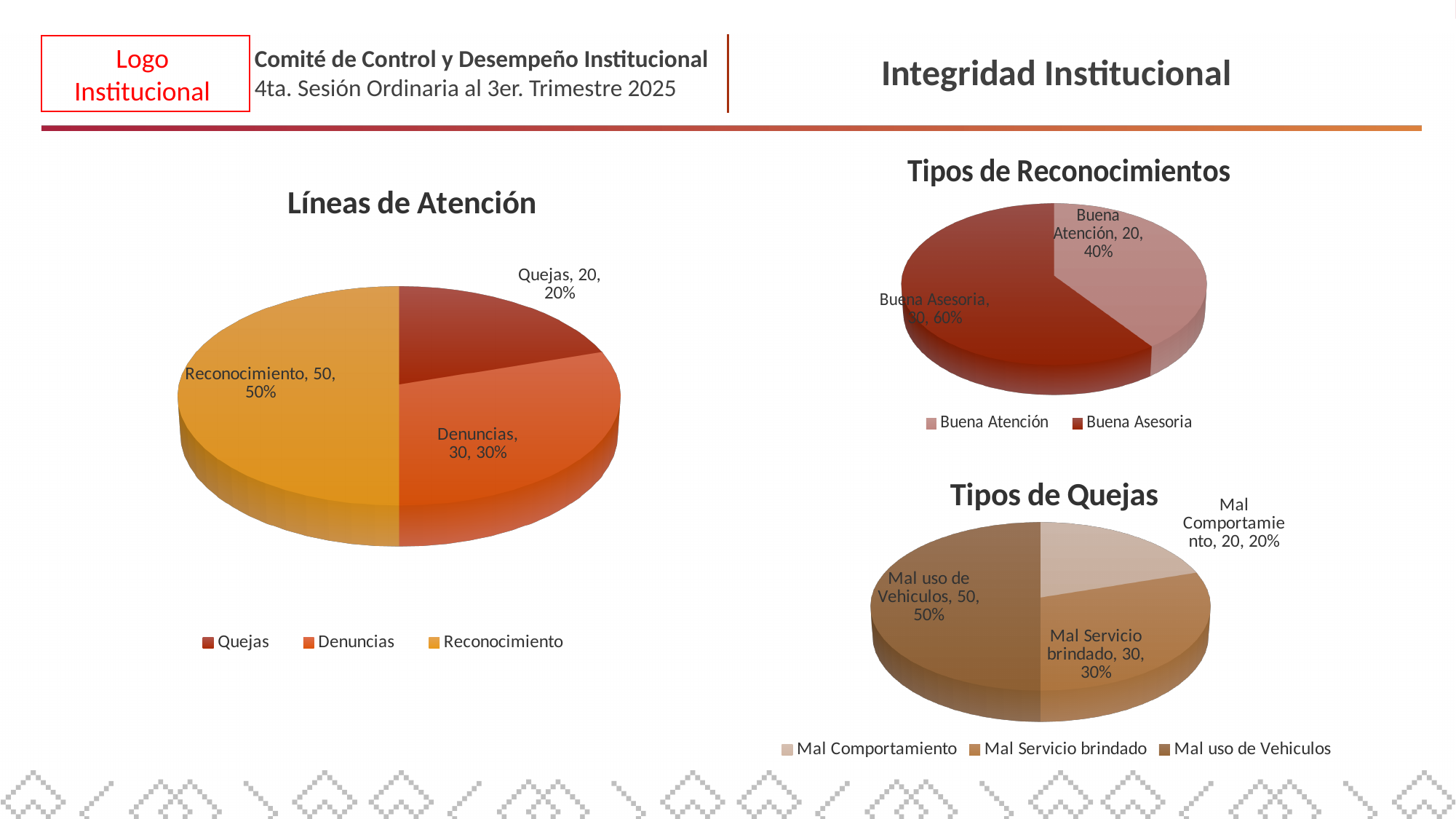
In the 'Líneas de Atención' chart, what is the value for Denuncias? 30 How many categories does the 'Líneas de Atención' chart show? 3 What kind of chart is 'Tipos de Reconocimientos'? Pie chart In the 'Líneas de Atención' chart, which category has the smallest slice? Quejas In the 'Tipos de Reconocimientos' chart, what is the value for Buena Asesoria? 30 How many entries does the legend of the 'Tipos de Quejas' chart list? 3 In the 'Tipos de Reconocimientos' chart, what share of the pie does Buena Atención represent? 40% In the 'Tipos de Quejas' chart, which is larger: Mal Servicio brindado or Mal Comportamiento? Mal Servicio brindado In the 'Líneas de Atención' chart, which category has the largest slice? Reconocimiento In the 'Líneas de Atención' chart, what is the difference between the values for Reconocimiento and Quejas? 30 In the 'Líneas de Atención' chart, what share of the pie does Reconocimiento represent? 50% In the 'Tipos de Quejas' chart, which category has the largest slice? Mal uso de Vehiculos